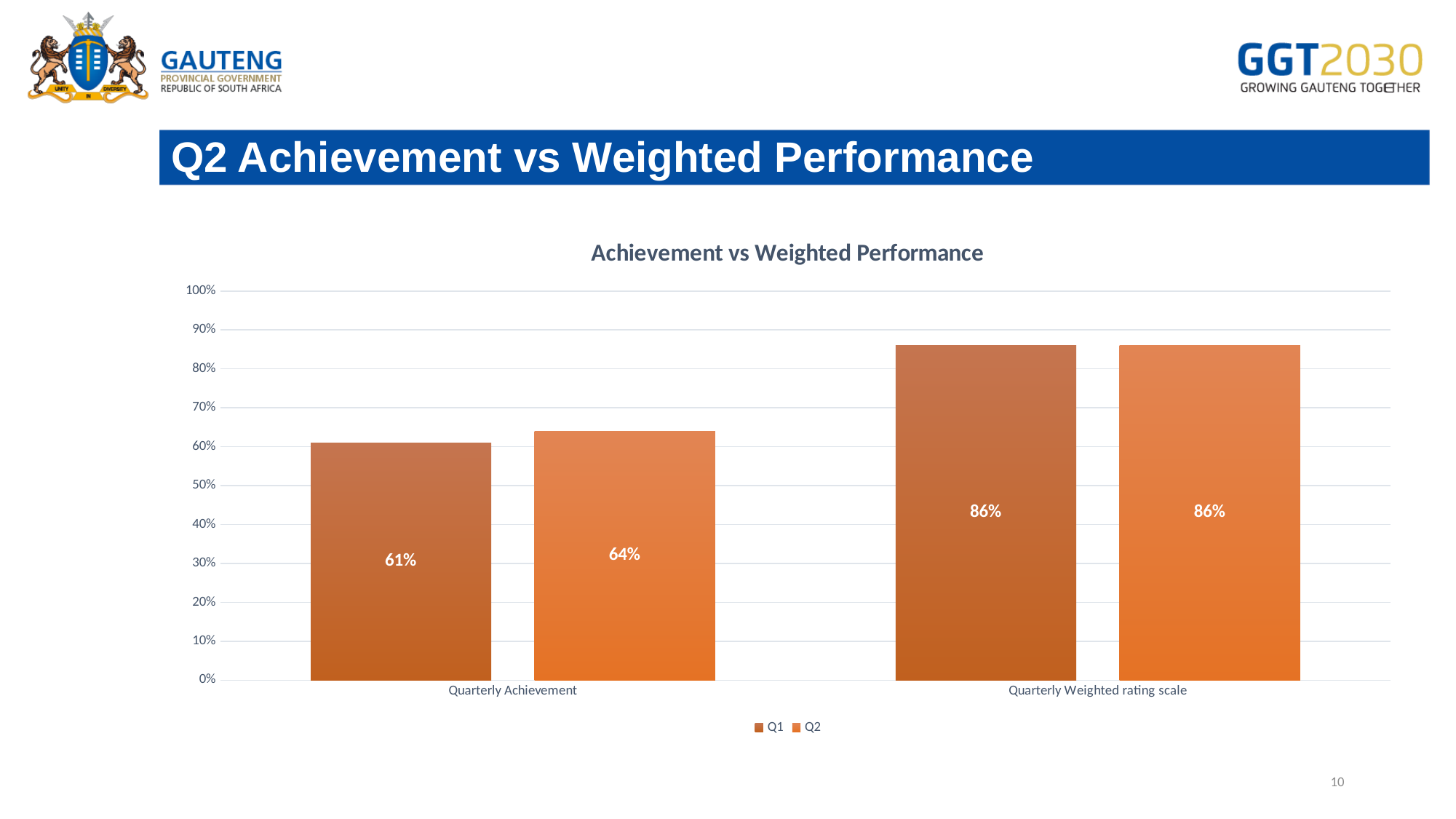
What is the difference between the Q2 and Q1 values for Quarterly Achievement? 3% For Quarterly Achievement, which series has the larger value, Q1 or Q2? Q2 Is the Q1 value for Quarterly Weighted rating scale greater or less than 80%? greater How many categories are shown on the x axis? 2 Which category has the lowest Q1 value? Quarterly Achievement How many series does the legend list? 2 What is the Q1 value for Quarterly Achievement? 61% What is the Q1 value for Quarterly Weighted rating scale? 86% What is the Q2 value for Quarterly Weighted rating scale? 86% Which category has the highest Q2 value? Quarterly Weighted rating scale What kind of chart is shown on the slide? Bar chart What is the Q2 value for Quarterly Achievement? 64%